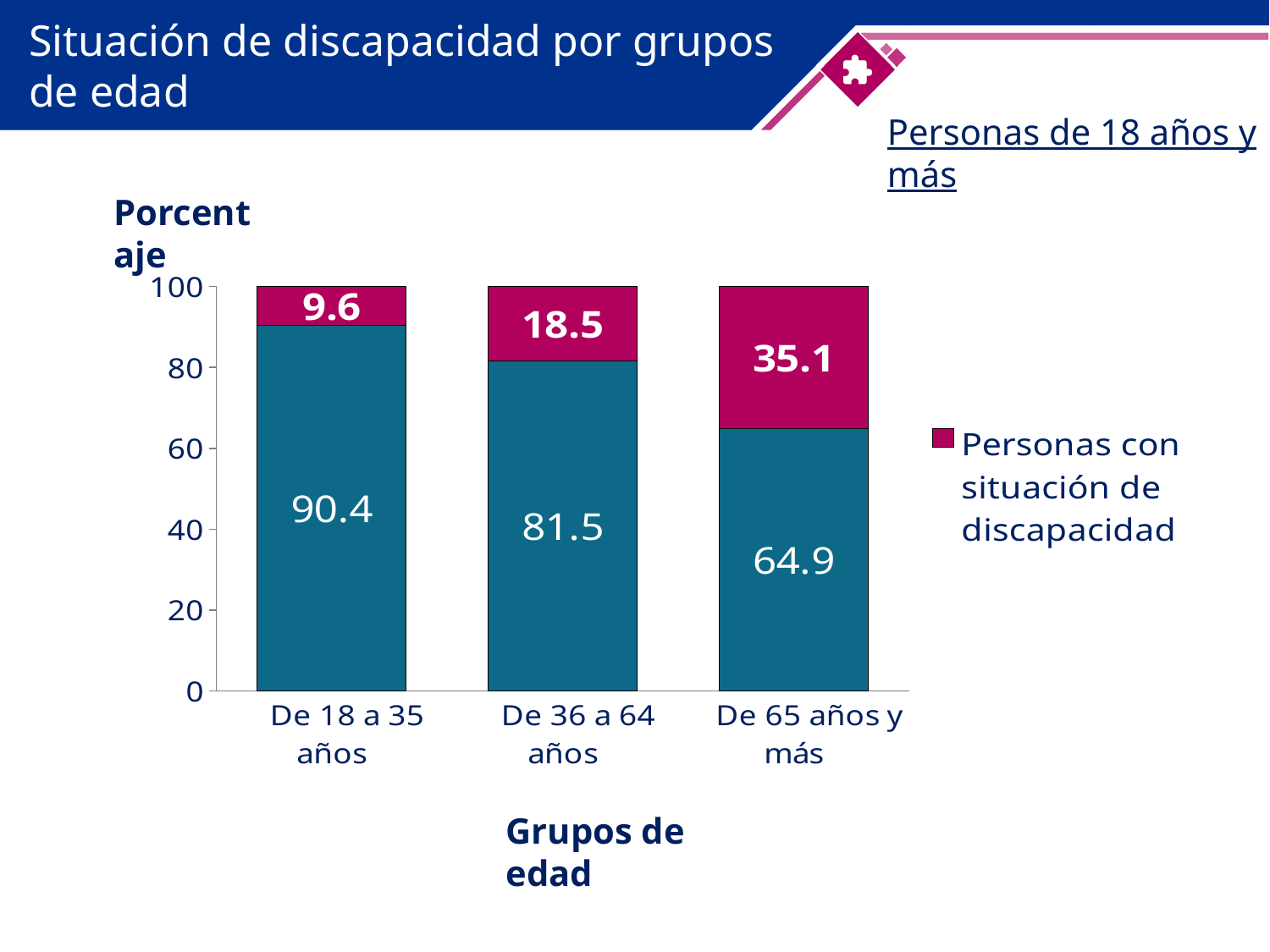
How many age groups are shown on the x axis? 3 What is the value for 'Personas con situación de discapacidad' in the 'De 36 a 64 años' group? 18.5 Which group has a larger value for 'Personas con situación de discapacidad': 'De 36 a 64 años' or 'De 18 a 35 años'? De 36 a 64 años What is the title of the x axis? Grupos de edad What is the value for 'Personas con situación de discapacidad' in the 'De 65 años y más' group? 35.1 How many series does the legend list? 1 Which age group has the highest value for 'Personas con situación de discapacidad'? De 65 años y más What is the value for 'Personas con situación de discapacidad' in the 'De 18 a 35 años' group? 9.6 Do the values for 'Personas con situación de discapacidad' rise or fall from the youngest to the oldest age group? Rise Which age group has the lowest value for 'Personas con situación de discapacidad'? De 18 a 35 años What is the difference between the 'Personas con situación de discapacidad' values for 'De 65 años y más' and 'De 18 a 35 años'? 25.5 What kind of chart is shown on the slide? Stacked bar chart